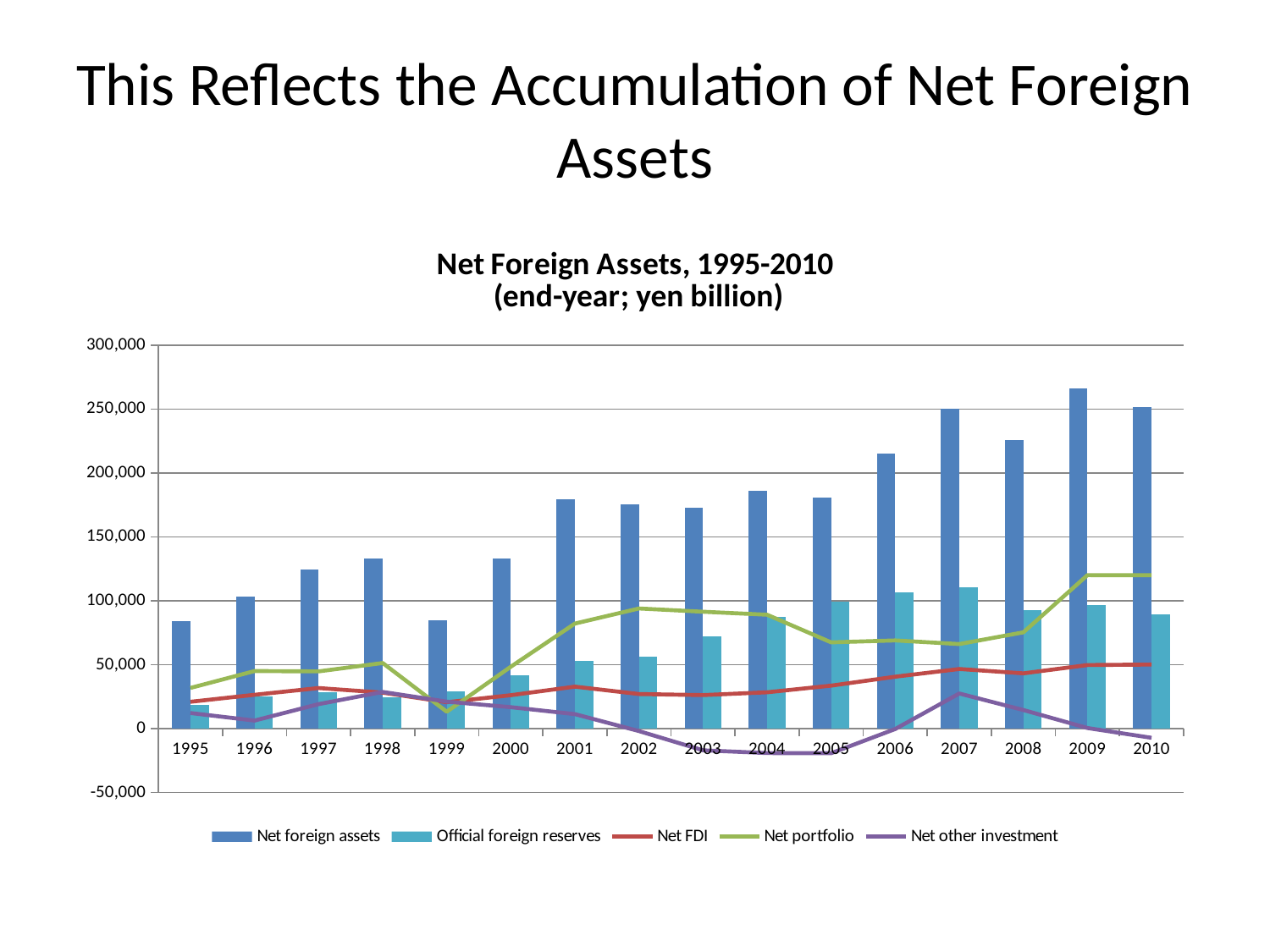
Which series is larger in 2009, Net portfolio or Net FDI? Net portfolio Is the value of Net foreign assets in 2009 greater or less than 250,000? greater In which year is the Net foreign assets bar highest? 2009 What kind of chart is shown on the slide? Combined bar and line chart Which is larger, Net foreign assets in 2007 or in 2008? 2007 Is the value of Net other investment in 2004 greater or less than 0? less Is the value of Net portfolio in 2009 greater or less than 100,000? greater How many series does the legend list? 5 How many years are shown on the x axis? 16 What is the title of the chart? Net Foreign Assets, 1995-2010 (end-year; yen billion) Overall, do Net foreign assets rise or fall from 1995 to 2010? rise